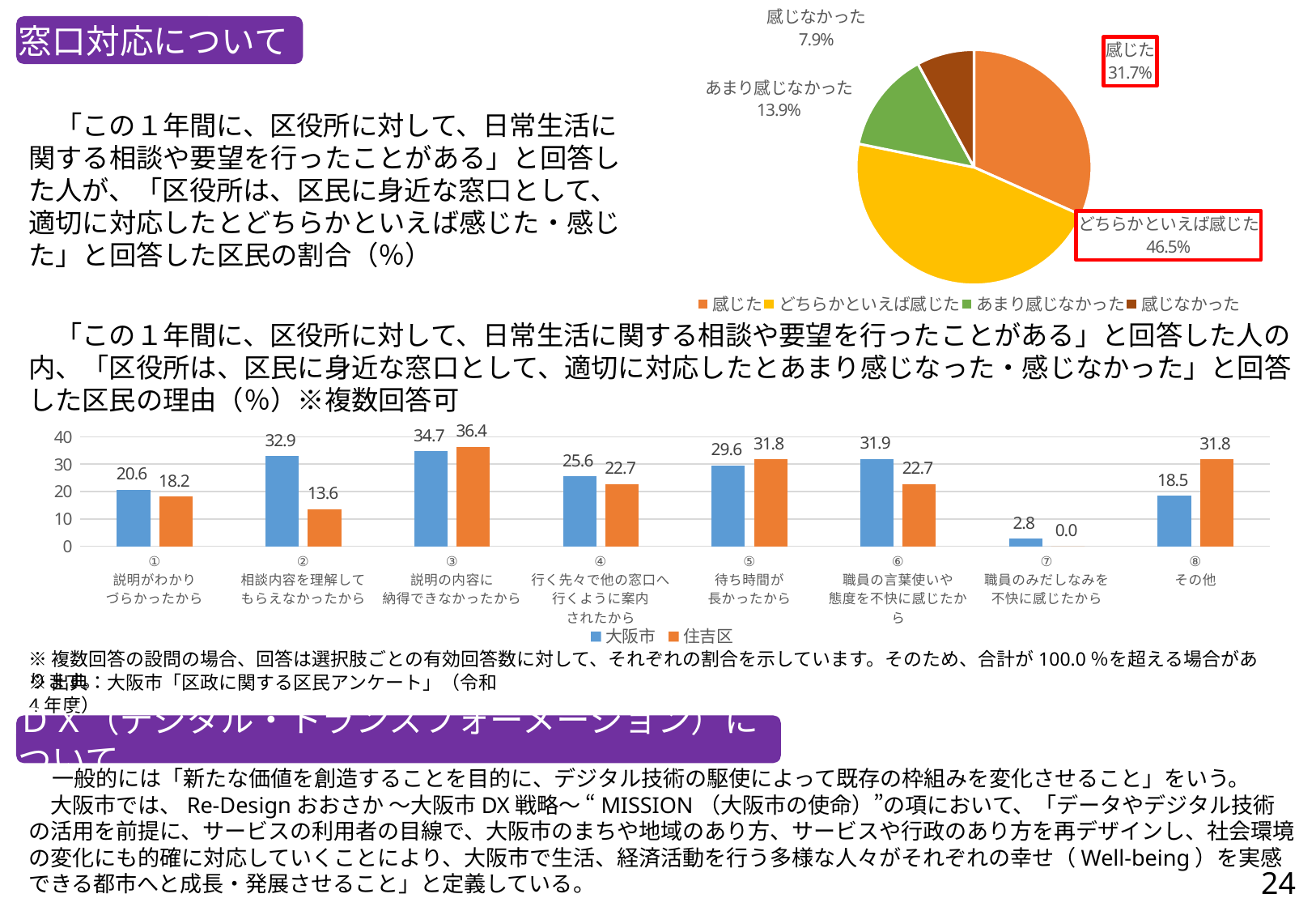
In the bar chart at the bottom, what is the difference between 大阪市 and 住吉区 in category ②? 19.3 In the pie chart at the top right, which category has the largest slice? どちらかといえば感じた How many categories does the legend of the pie chart at the top right list? 4 In the bar chart at the bottom, what is the value for 大阪市 in category ⑥? 31.9 In the pie chart at the top right, what share is labelled for どちらかといえば感じた? 46.5% In the bar chart at the bottom, which category has the lowest value for 住吉区? ⑦ In the bar chart at the bottom, which category has the highest value for 大阪市? ③ How many series does the legend of the bar chart at the bottom list? 2 In the bar chart at the bottom, what is the value for 住吉区 in category ②? 13.6 In the pie chart at the top right, what is the difference between 感じた and あまり感じなかった? 17.8% In the pie chart at the top right, what is the value for 感じなかった? 7.9% In the bar chart at the bottom, which is larger in category ⑧, 大阪市 or 住吉区? 住吉区